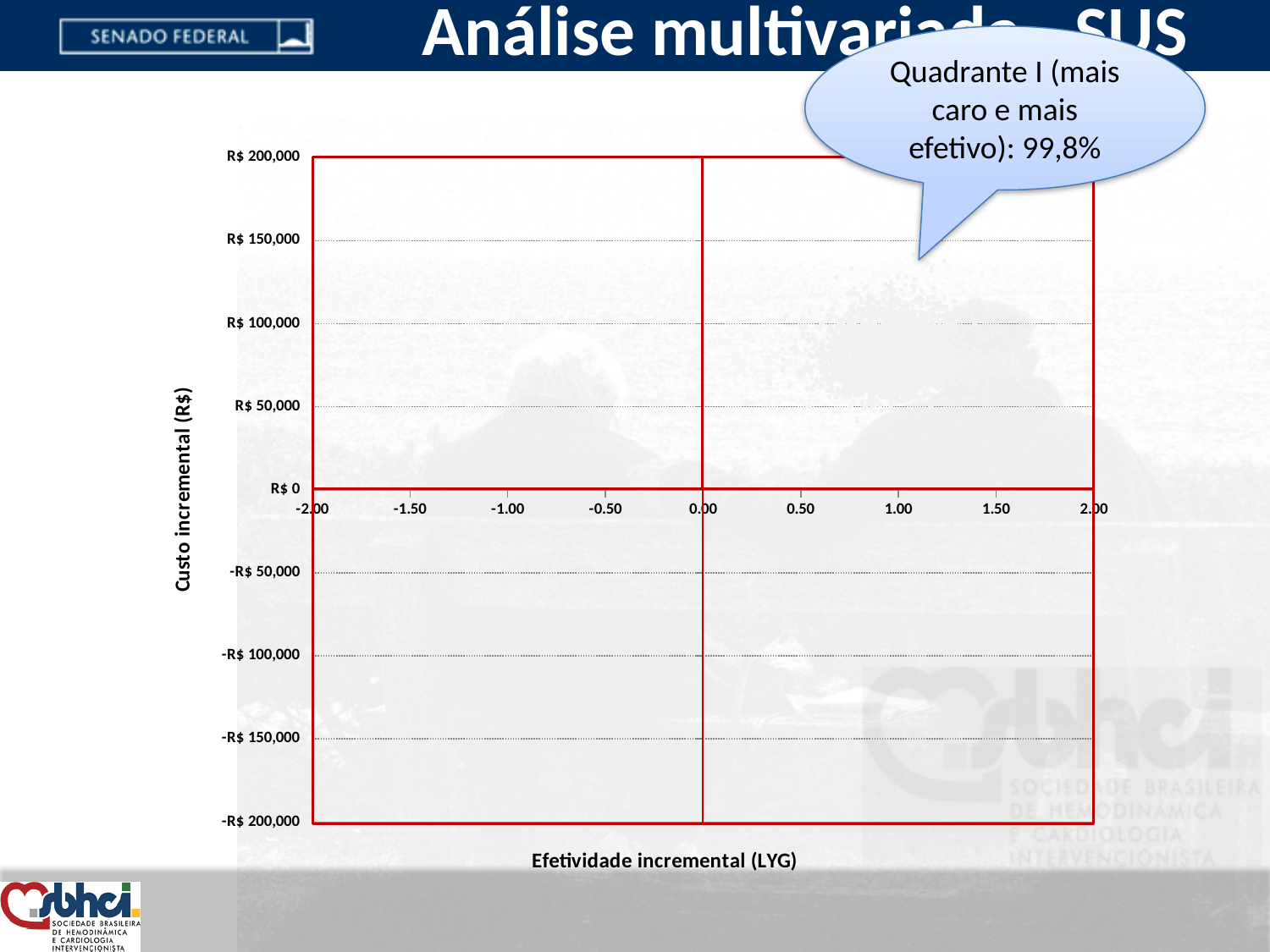
Is the cluster of plotted points located at an incremental cost greater or less than R$ 0? greater How many tick labels are shown on the horizontal axis of the chart? 9 Is the cluster of plotted points located at an incremental effectiveness greater or less than 2.00 LYG? less What is the lowest value shown on the horizontal axis of the chart? -2.00 According to the callout on the chart, what percentage of points fall in Quadrante I (mais caro e mais efetivo)? 99,8% Is the cluster of plotted points located at an incremental effectiveness greater or less than 0.00 LYG? greater What kind of chart is shown on the slide? scatter plot What is the highest value shown on the vertical axis of the chart? R$ 200,000 What is the label of the vertical axis of the chart? Custo incremental (R$) What is the label of the horizontal axis of the chart? Efetividade incremental (LYG)